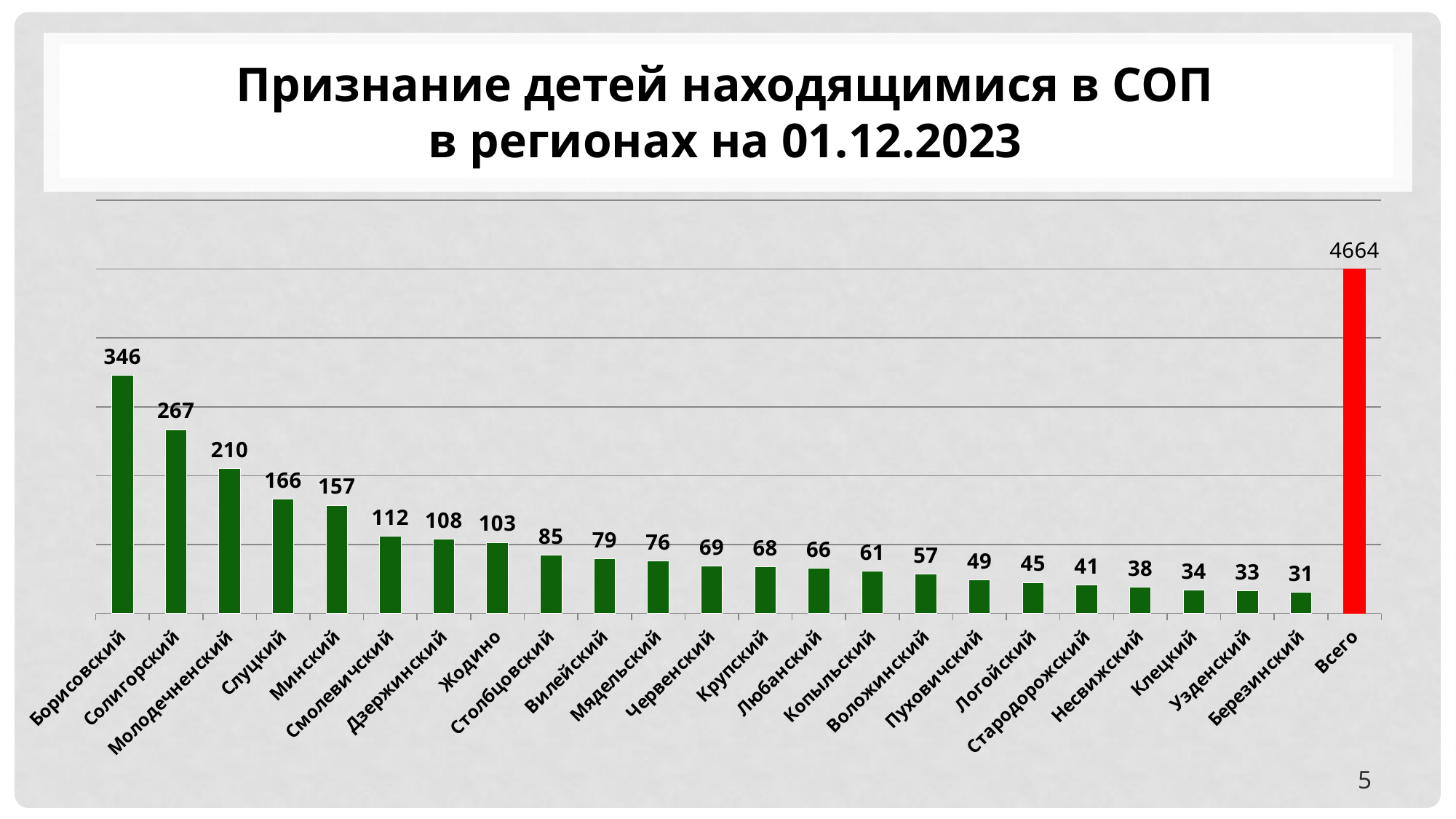
What is the value for Минский? 157 What colour is the bar for Всего? Red Which region (excluding Всего) has the highest value? Борисовский What kind of chart is shown on the slide? Bar chart Which is larger, the value for Жодино or the value for Столбцовский? Жодино What is the value for Березинский? 31 What is the value for Борисовский? 346 Which category has the lowest value? Березинский How many bars are shown on the chart, including Всего? 24 What is the difference between the values for Солигорский and Молодечненский? 57 Do the values for the regions rise or fall from left to right (excluding Всего)? Fall What is the value shown for Всего? 4664